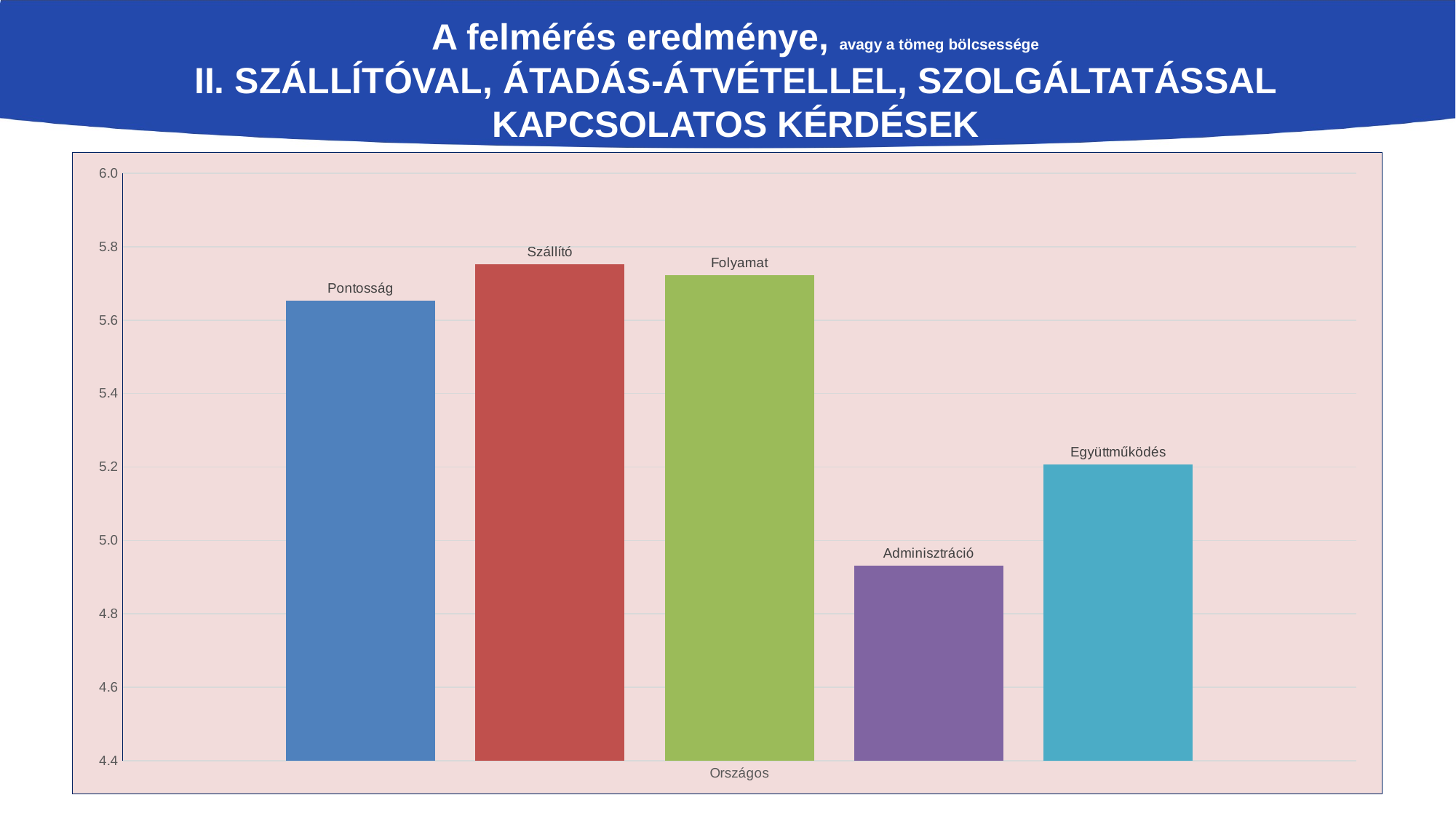
Is the value for Pontosság greater or less than 5.6? greater What colour is the Adminisztráció bar? purple What label is shown on the x axis below the bars? Országos Which bar has the lowest value in the chart? Adminisztráció Is the value for Együttműködés greater or less than 5.4? less Is the value for Folyamat greater or less than 5.6? greater How many bars are plotted in the chart? 5 What kind of chart is shown on the slide? bar chart Which is larger, the value for Szállító or the value for Együttműködés? Szállító Which is larger, the value for Pontosság or the value for Adminisztráció? Pontosság